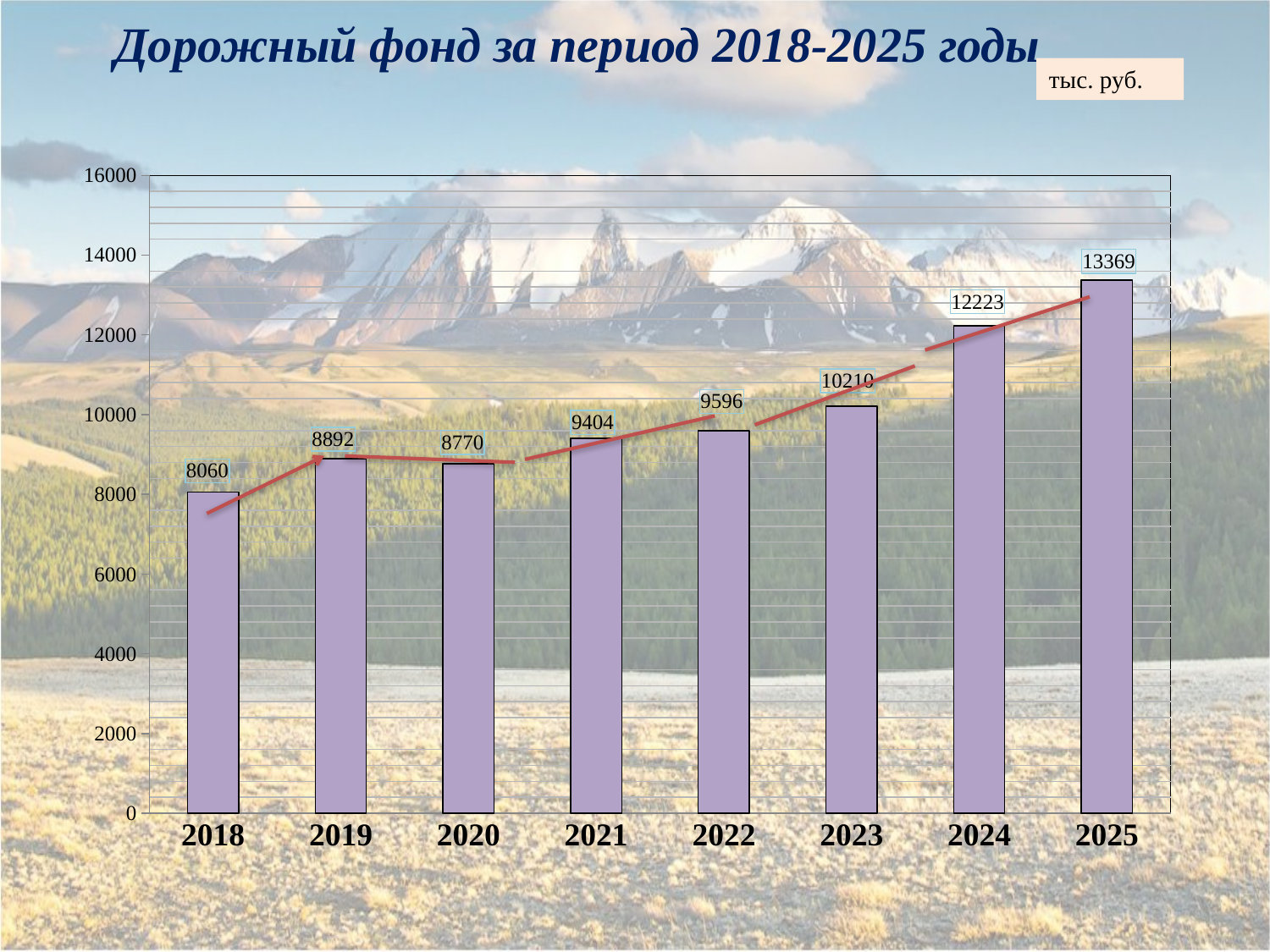
Which year has the highest value? 2025 What kind of chart is shown on the slide? bar chart How many years are shown on the x axis? 8 What is the difference between the values for 2025 and 2024? 1146 Which is larger, the value for 2019 or the value for 2020? 2019 What is the value for 2025? 13369 What is the difference between the values for 2019 and 2020? 122 Which year has the lowest value? 2018 What unit is indicated for the values on the chart? тыс. руб. What is the value for 2023? 10210 What is the value for 2018? 8060 Is the value for 2024 greater or less than 12000? greater